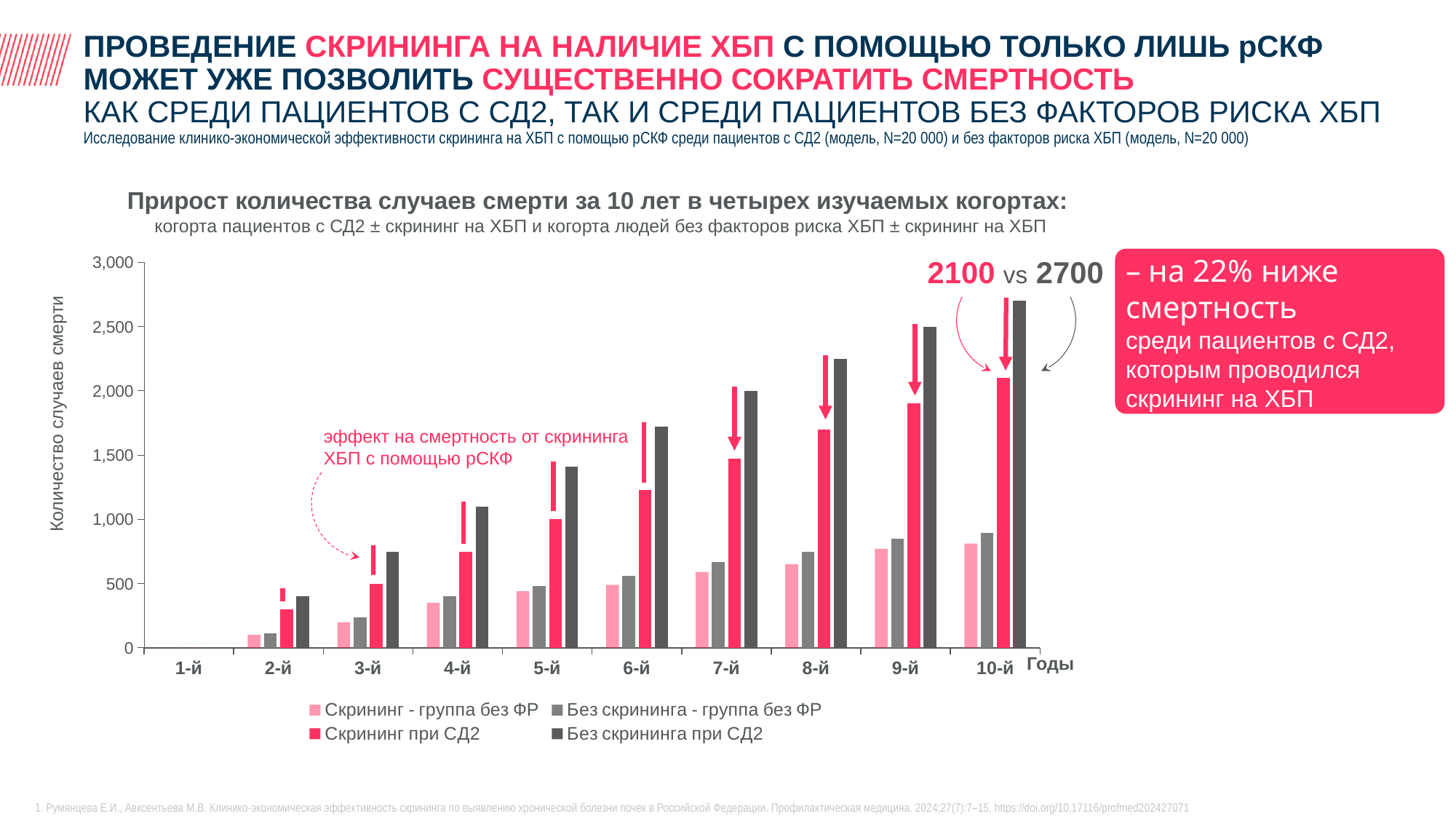
Do the values for 'Без скрининга при СД2' rise or fall from year 1-й to year 10-й? rise What is the title of the vertical axis? Количество случаев смерти Which series has the highest value in year 10-й? Без скрининга при СД2 What is the difference between 'Без скрининга при СД2' and 'Скрининг при СД2' in year 10-й? 600 How many year categories are shown on the x axis? 10 Is the value for 'Без скрининга при СД2' in year 8-й greater or less than 2,000? greater What is the value for 'Без скрининга при СД2' in year 10-й? 2700 What kind of chart is shown on the slide? bar chart Is the value for 'Скрининг при СД2' in year 6-й greater or less than 1,500? less How many series does the legend list? 4 In year 10-й, which is larger: 'Скрининг при СД2' or 'Без скрининга при СД2'? Без скрининга при СД2 What is the value for 'Скрининг при СД2' in year 10-й? 2100